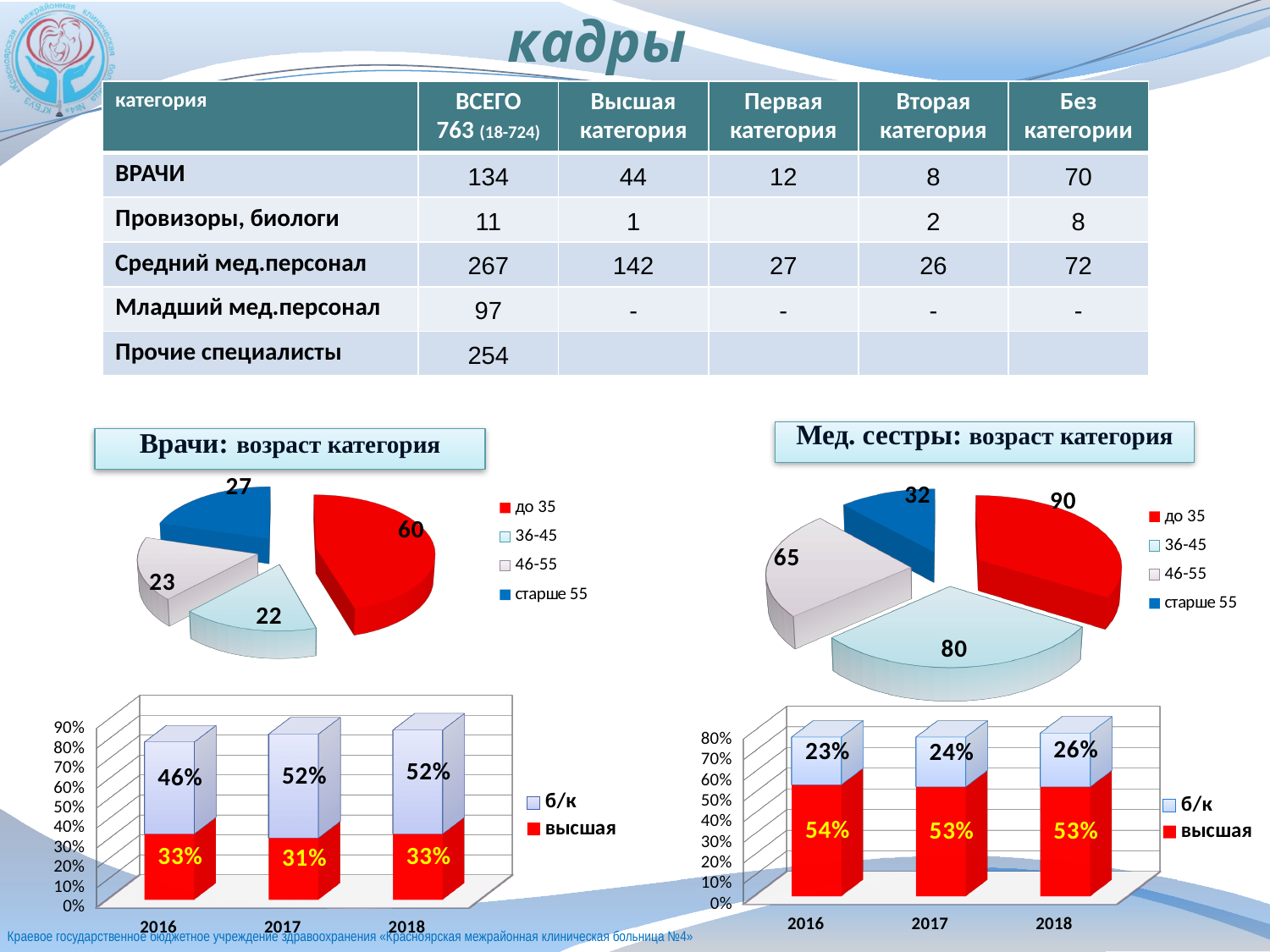
In the bottom-left bar chart, what is the value of 'высшая' for 2017? 31% In the pie chart 'Врачи: возраст категория', what is the value for the 'до 35' slice? 60 In the bottom-left bar chart, what is the value of 'б/к' for 2016? 46% In the bottom-right bar chart, what is the total of the stacked bar for 2016? 77% How many slices does the pie chart 'Врачи: возраст категория' have? 4 In the pie chart 'Врачи: возраст категория', which age group has the largest slice? до 35 In the pie chart 'Мед. сестры: возраст категория', what is the difference between the 'до 35' and '36-45' values? 10 In the bottom-right bar chart, does the 'б/к' value rise or fall from 2016 to 2018? rise How many series does the legend of the bottom-left bar chart list? 2 In the pie chart 'Мед. сестры: возраст категория', what is the value for the '46-55' slice? 65 In the bottom-right bar chart, what is the value of 'б/к' for 2018? 26% In the pie chart 'Мед. сестры: возраст категория', which age group has the smallest slice? старше 55